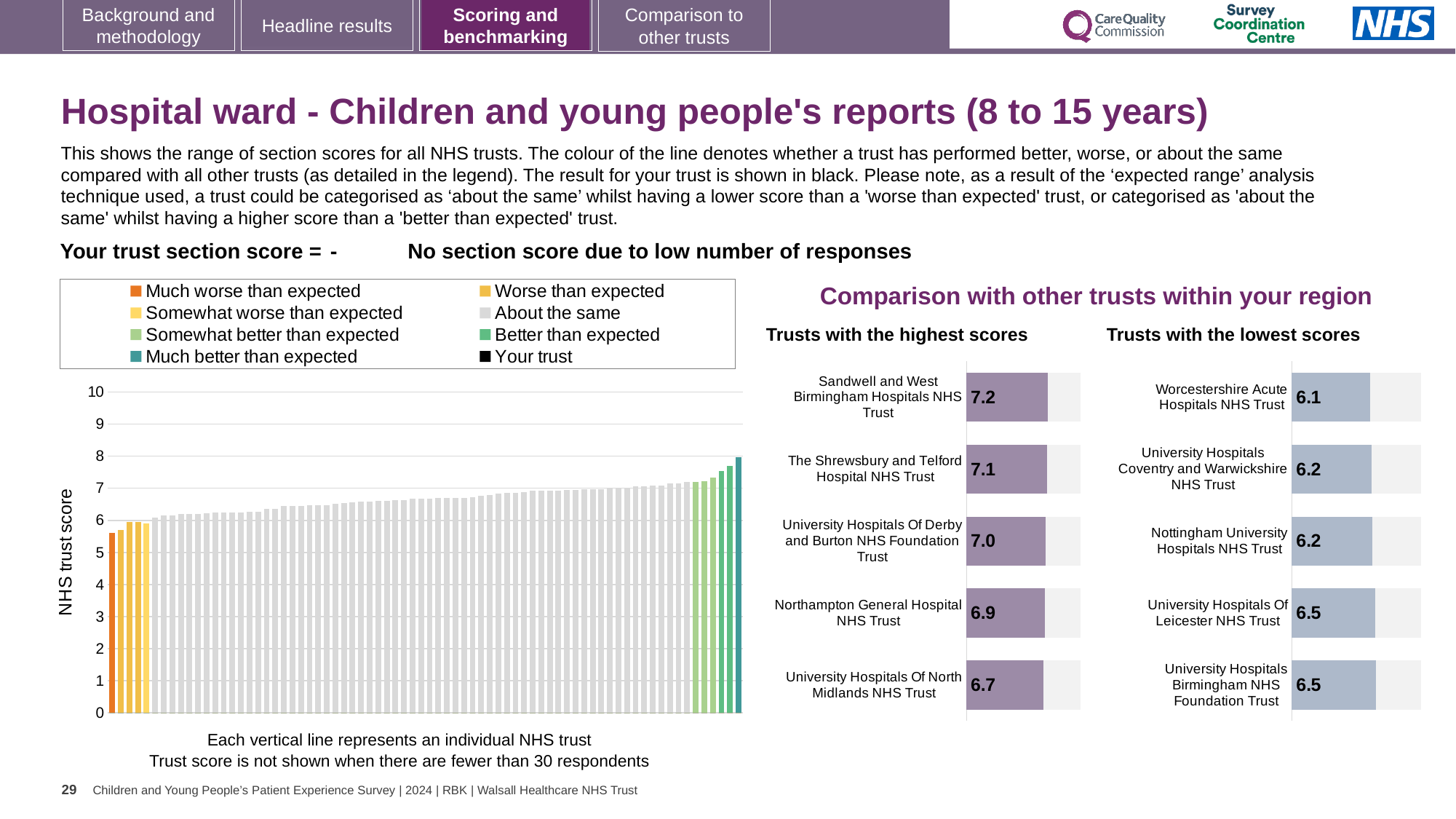
What type of chart is the large 'NHS trust score' chart on the left of the slide? Bar chart In the 'Trusts with the highest scores' chart, what is the score for University Hospitals Of North Midlands NHS Trust? 6.7 In the 'Trusts with the highest scores' chart, which trust has the highest score? Sandwell and West Birmingham Hospitals NHS Trust In the 'Trusts with the lowest scores' chart, what is the score for University Hospitals Of Leicester NHS Trust? 6.5 In the 'Trusts with the lowest scores' chart, which trust has the lowest score? Worcestershire Acute Hospitals NHS Trust How many trusts are listed in the 'Trusts with the lowest scores' chart? 5 In the 'Trusts with the highest scores' chart, what is the difference between the scores of Sandwell and West Birmingham Hospitals NHS Trust and University Hospitals Of North Midlands NHS Trust? 0.5 In the 'Trusts with the lowest scores' chart, what is the score for Worcestershire Acute Hospitals NHS Trust? 6.1 In the 'Trusts with the highest scores' chart, what is the score for Sandwell and West Birmingham Hospitals NHS Trust? 7.2 How many entries does the legend above the 'NHS trust score' chart list? 8 In the 'NHS trust score' chart on the left, do the bar values rise or fall from left to right? Rise Which has the higher score: The Shrewsbury and Telford Hospital NHS Trust in the 'highest scores' chart or Nottingham University Hospitals NHS Trust in the 'lowest scores' chart? The Shrewsbury and Telford Hospital NHS Trust